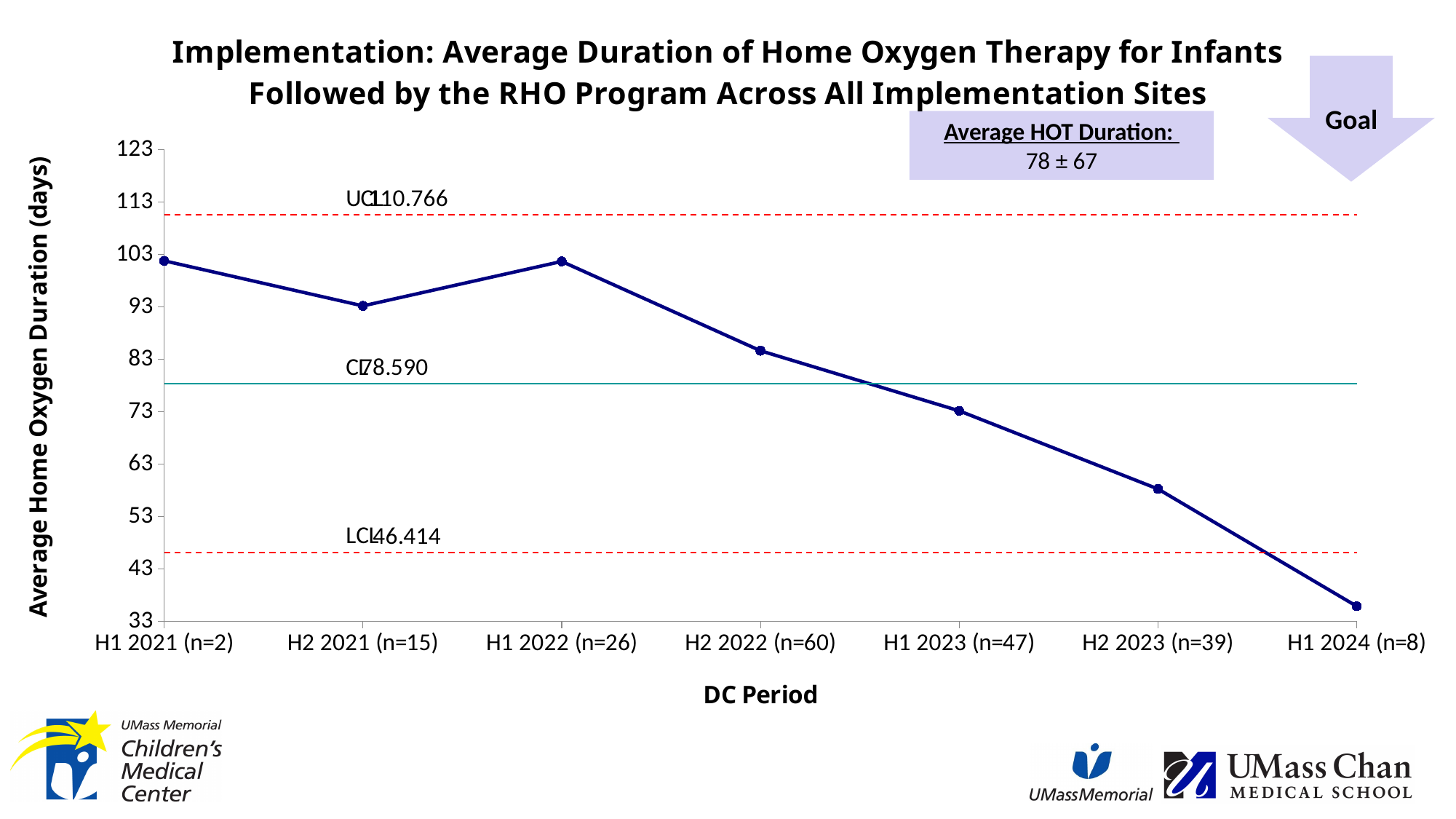
Which is larger, the value for H2 2021 (n=15) or the value for H2 2023 (n=39)? H2 2021 (n=15) Which DC period has the lowest average home oxygen duration? H1 2024 (n=8) Do the plotted values generally rise or fall from H1 2022 to H1 2024? fall Is the value for H1 2021 (n=2) greater or less than 93? greater Is the value for H2 2023 (n=39) greater or less than 63? less What is the UCL value printed on the chart? 110.766 What is the CL value printed on the chart? 78.590 What is the LCL value printed on the chart? 46.414 What is the title of the x axis? DC Period Is the value for H1 2024 (n=8) greater or less than 43? less How many DC periods are plotted on the x axis? 7 What kind of chart is shown on the slide? line chart